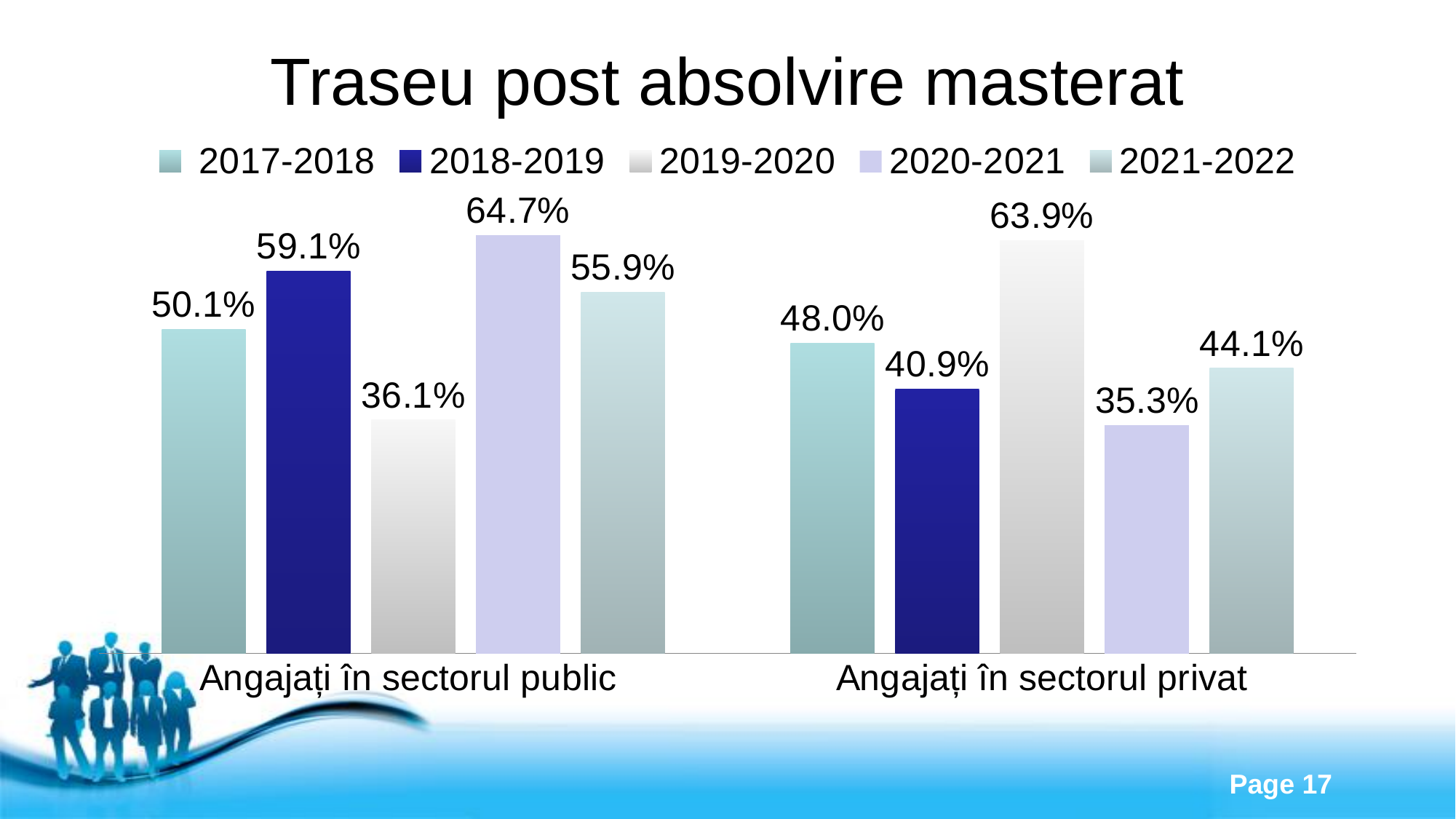
What kind of chart is shown on the slide? Bar chart Which series has the lowest value in the 'Angajați în sectorul privat' category? 2020-2021 What is the value for 2020-2021 in the 'Angajați în sectorul privat' category? 35.3% What is the value for 2019-2020 in the 'Angajați în sectorul privat' category? 63.9% What is the title of the chart? Traseu post absolvire masterat Which series has the highest value in the 'Angajați în sectorul public' category? 2020-2021 Which is larger: the 2021-2022 value for 'Angajați în sectorul public' or for 'Angajați în sectorul privat'? Angajați în sectorul public How many categories are shown on the x axis? 2 What is the value for 2018-2019 in the 'Angajați în sectorul public' category? 59.1% How many series does the legend list? 5 What is the difference between the 2020-2021 and 2019-2020 values in the 'Angajați în sectorul public' category? 28.6% What is the difference between the 2017-2018 values for the public and private sector categories? 2.1%